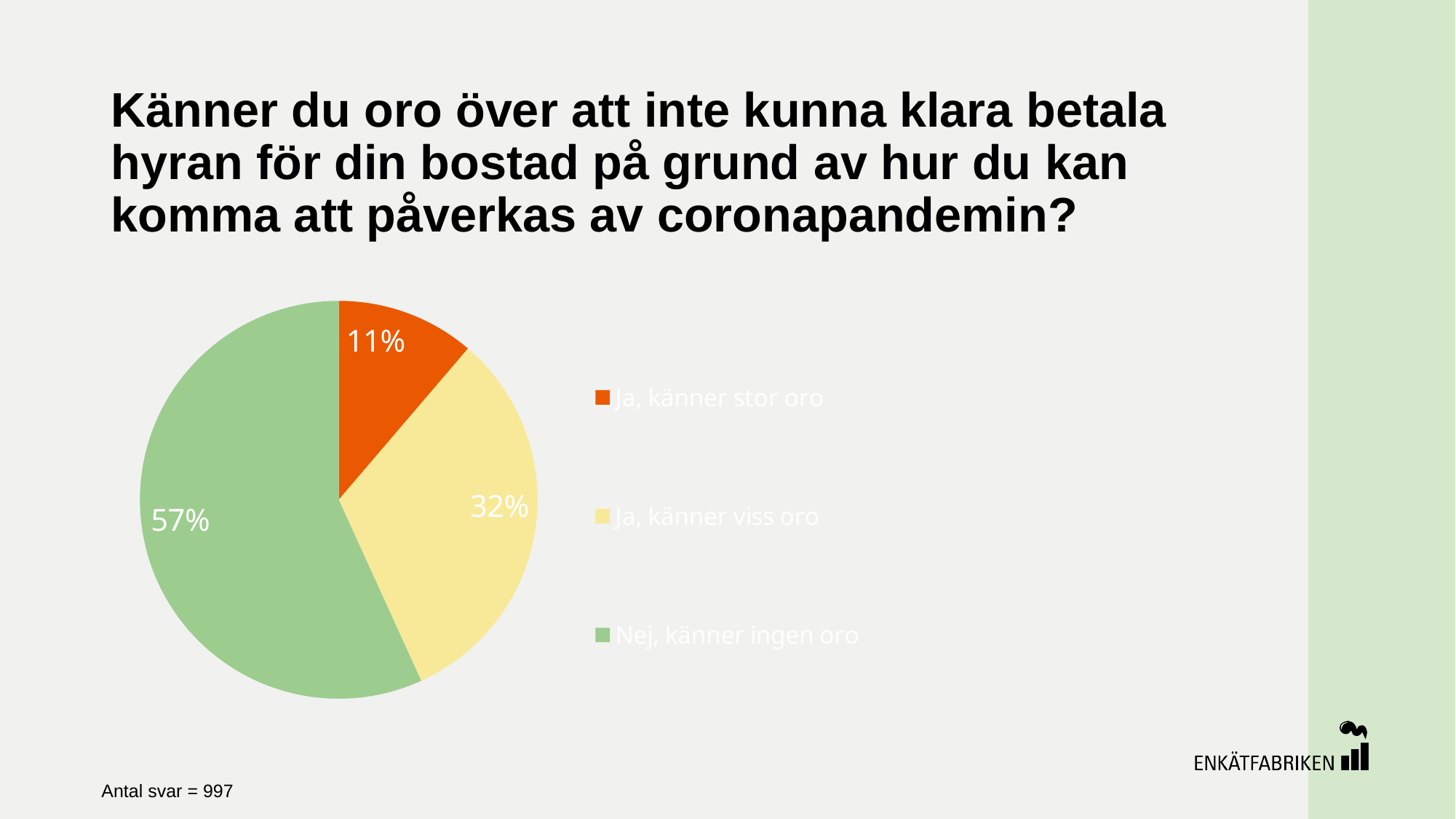
What share of respondents answered "Ja, känner stor oro"? 11% What share of respondents answered "Nej, känner ingen oro"? 57% What kind of chart is shown on the slide? pie chart Which response has the largest share of the pie? Nej, känner ingen oro How many percentage points larger is the share for "Ja, känner viss oro" than for "Ja, känner stor oro"? 21 Which response has the smallest share of the pie? Ja, känner stor oro How many slices does the pie chart have? 3 Which is larger: the share for "Ja, känner viss oro" or the share for "Ja, känner stor oro"? Ja, känner viss oro What colour is the slice for "Ja, känner stor oro"? orange What share of respondents answered "Ja, känner viss oro"? 32% How many entries does the legend list? 3 How many percentage points larger is the share for "Nej, känner ingen oro" than for "Ja, känner viss oro"? 25